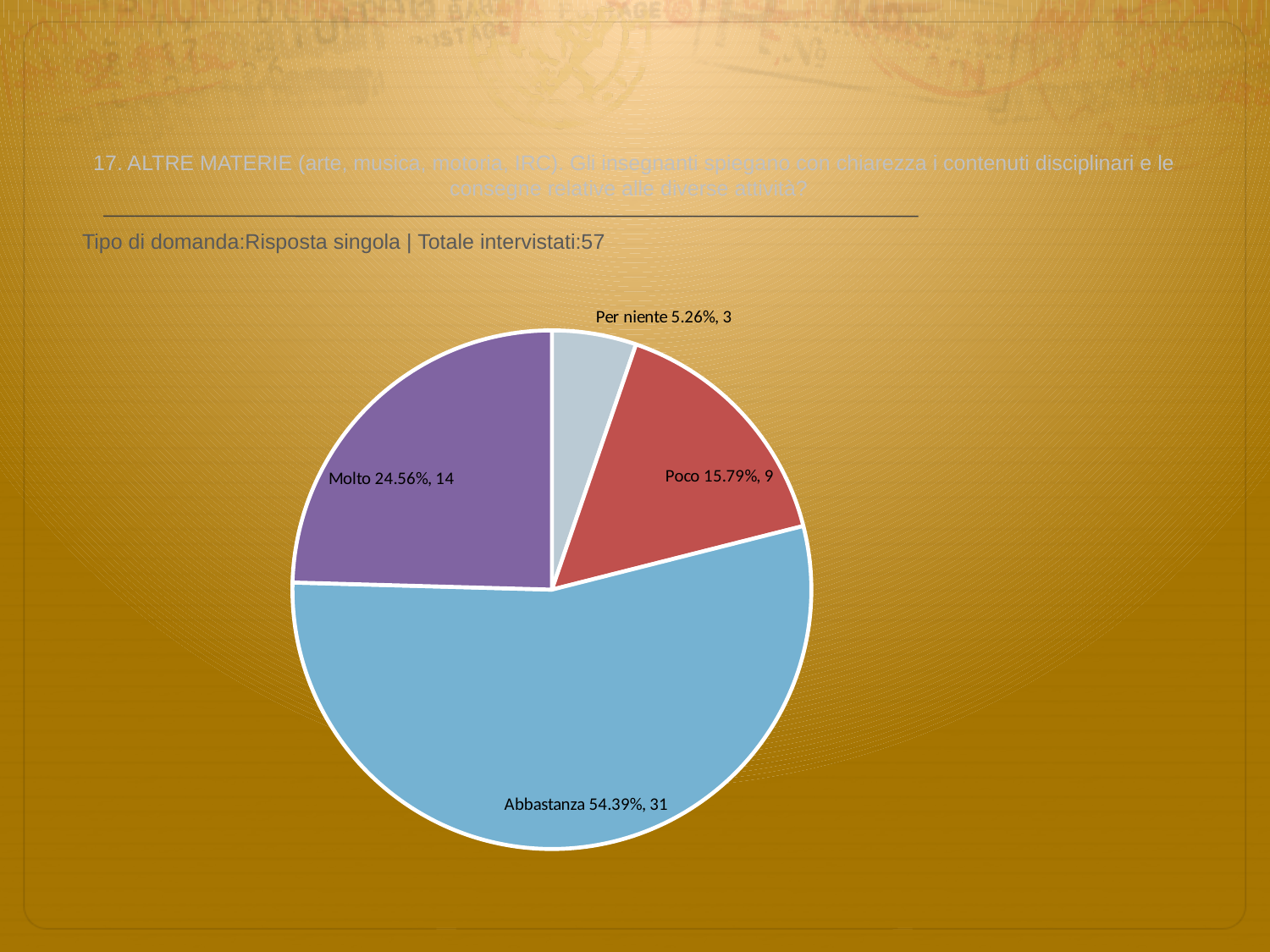
What is the total number of respondents across all slices? 57 What kind of chart is shown on the slide? pie chart What percentage share does the Poco slice have? 15.79% What colour is the Abbastanza slice? blue How many respondents answered Molto? 14 Which category has the largest slice? Abbastanza What percentage share does the Abbastanza slice have? 54.39% How many respondents answered Per niente? 3 Which category has the smallest slice? Per niente What is the difference in respondent count between Abbastanza and Molto? 17 Which has more respondents, Poco or Molto? Molto How many slices does the pie chart have? 4